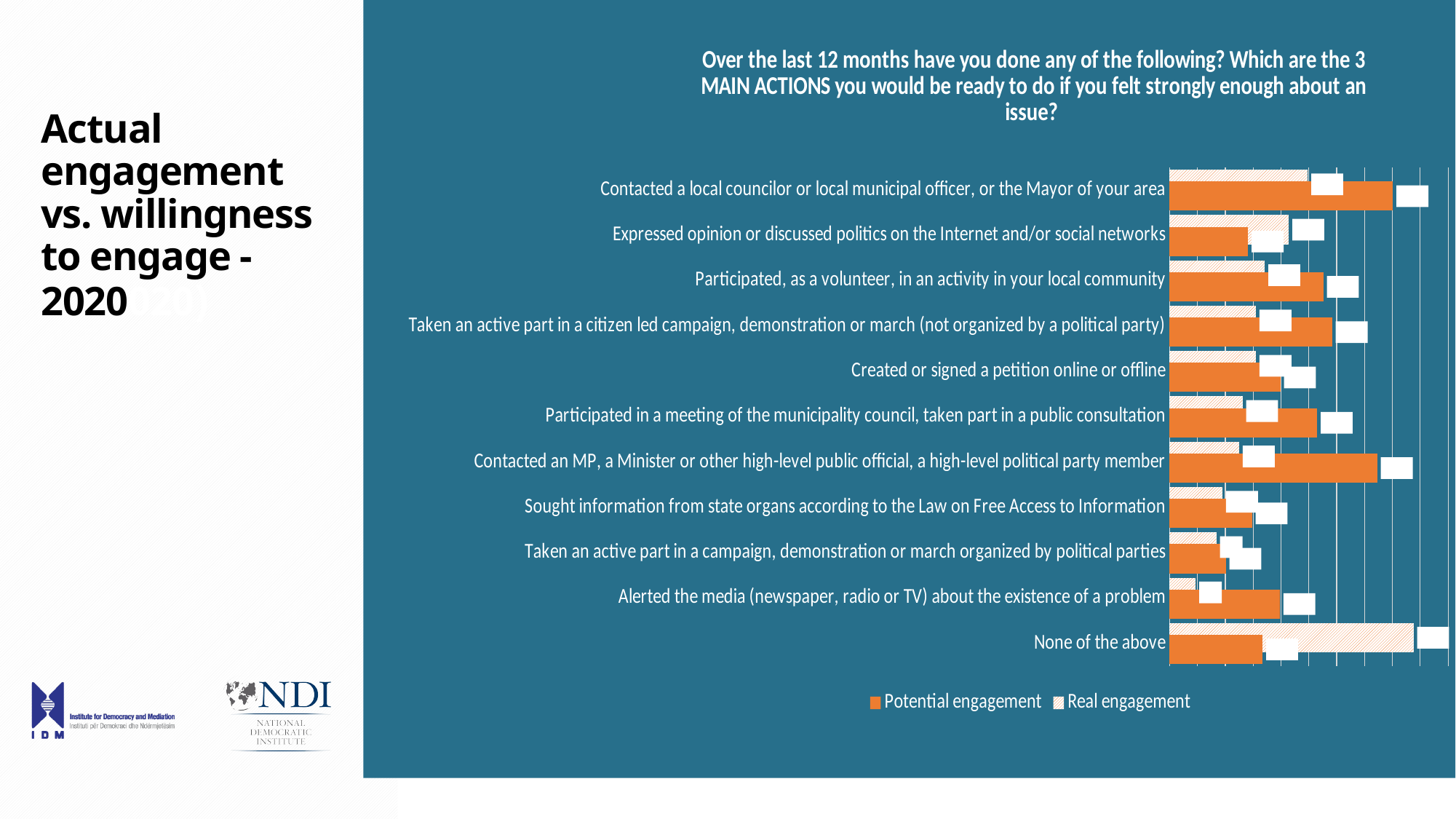
For 'Alerted the media (newspaper, radio or TV) about the existence of a problem', which is larger: Potential engagement or Real engagement? Potential engagement Which category has the highest Real engagement value? None of the above Which category has the lowest Potential engagement value? Taken an active part in a campaign, demonstration or march organized by political parties What are the two series named in the legend? Potential engagement and Real engagement How many series does the chart legend list? 2 For 'None of the above', which is larger: Potential engagement or Real engagement? Real engagement For 'Contacted a local councilor or local municipal officer, or the Mayor of your area', which is larger: Potential engagement or Real engagement? Potential engagement Which category has the lowest Real engagement value? Alerted the media (newspaper, radio or TV) about the existence of a problem How many categories (actions) are listed on the chart? 11 What kind of chart is shown on the slide? Bar chart Which series is shown with solid orange bars? Potential engagement